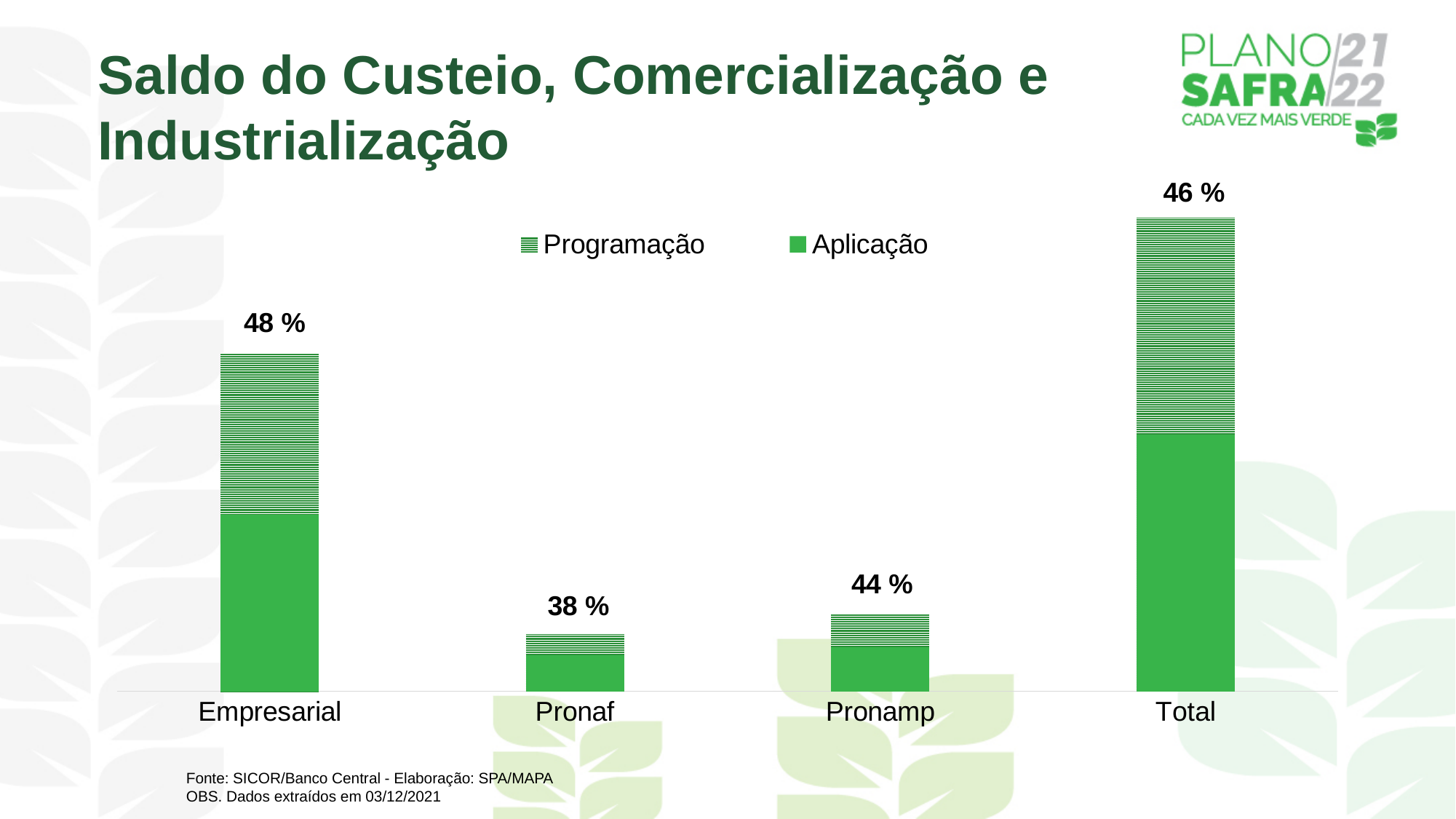
Which category has the highest percentage label? Empresarial What percentage label is shown above the Pronamp bar? 44 % Which has the larger percentage label, Pronamp or Pronaf? Pronamp What percentage label is shown above the Pronaf bar? 38 % What is the difference between the percentage labels for Empresarial and Pronaf? 10 percentage points What kind of chart is shown on the slide? Bar chart What percentage label is shown above the Total bar? 46 % Which category has the tallest stacked bar overall? Total Which category has the lowest percentage label? Pronaf How many categories are shown on the x axis? 4 How many series does the legend list? 2 What percentage label is shown above the Empresarial bar? 48 %